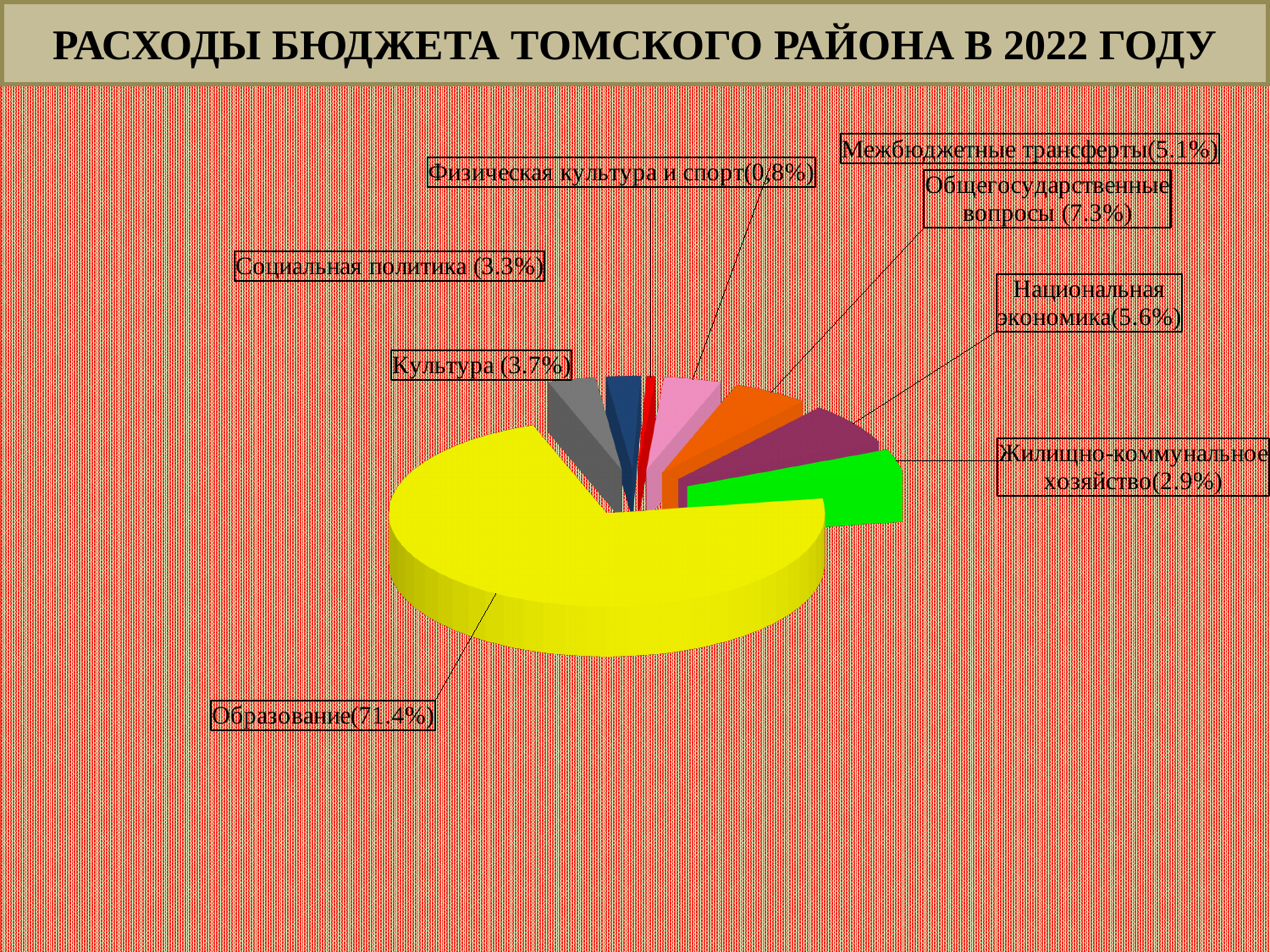
Which is larger, the share for Культура or the share for Социальная политика? Культура What is the title of the chart on the slide? РАСХОДЫ БЮДЖЕТА ТОМСКОГО РАЙОНА В 2022 ГОДУ What share of the budget expenses goes to Образование? 71.4% What share is shown for Жилищно-коммунальное хозяйство? 2.9% What share is shown for Общегосударственные вопросы? 7.3% What is the difference between the shares for Общегосударственные вопросы and Межбюджетные трансферты? 2.2% What share is shown for Национальная экономика? 5.6% What kind of chart is shown on the slide? pie chart Which category has the largest share of the pie? Образование Which category has the smallest share of the pie? Физическая культура и спорт How many categories are shown in the pie chart? 8 What share is shown for Физическая культура и спорт? 0,8%